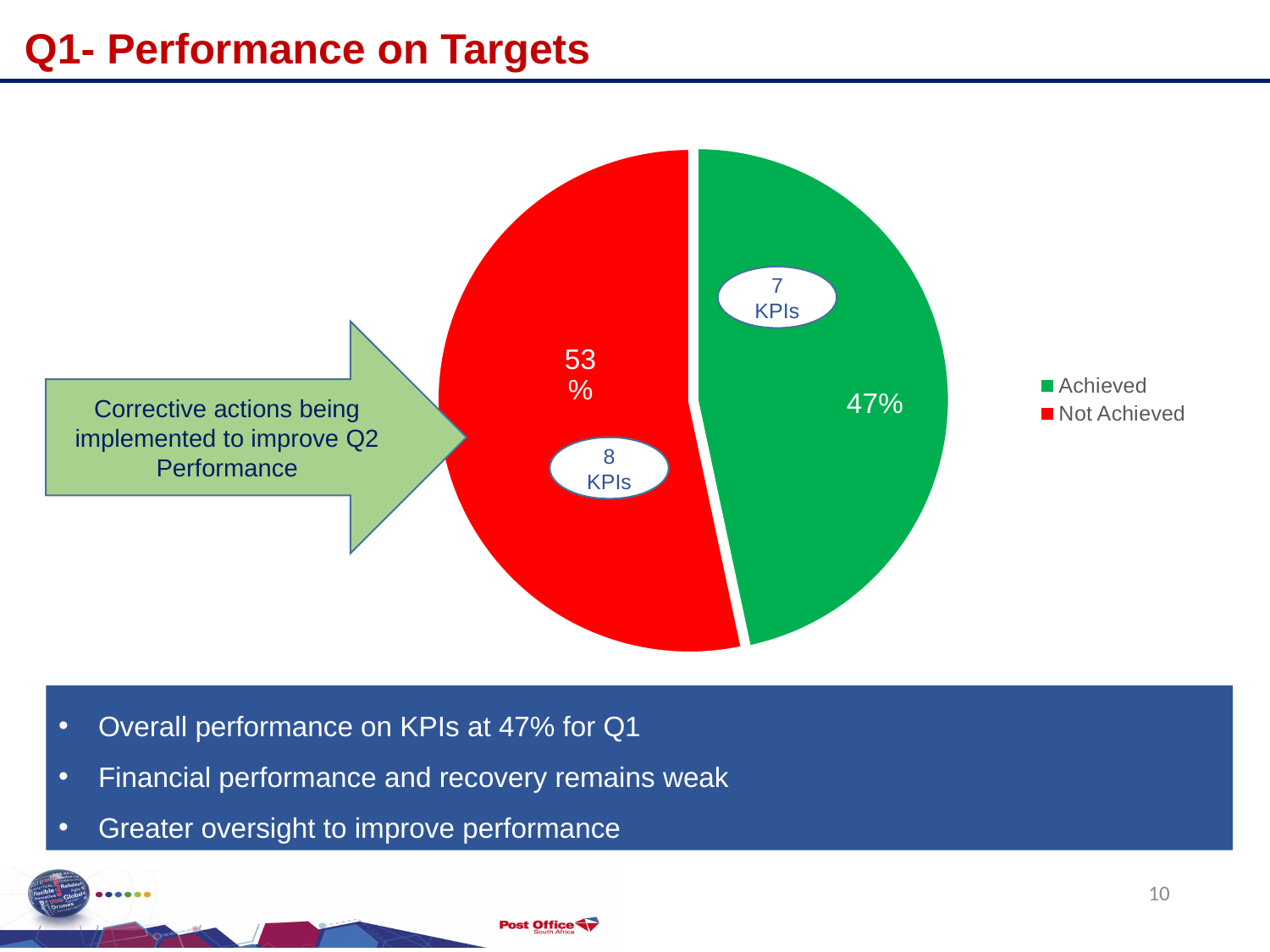
Which category has the smallest share of the pie? Achieved What is the title of the slide containing the pie chart? Q1- Performance on Targets Which slice of the pie is larger, Achieved or Not Achieved? Not Achieved How many slices does the pie chart have? 2 What colour is the Not Achieved slice? red How many KPIs are shown in the Achieved slice? 7 KPIs What percentage of the pie is labelled Not Achieved? 53% How many entries does the legend list? 2 What is the difference in percentage points between the Not Achieved and Achieved slices? 6 What kind of chart is shown on the slide? pie chart How many KPIs are shown in the Not Achieved slice? 8 KPIs What percentage of the pie is labelled Achieved? 47%